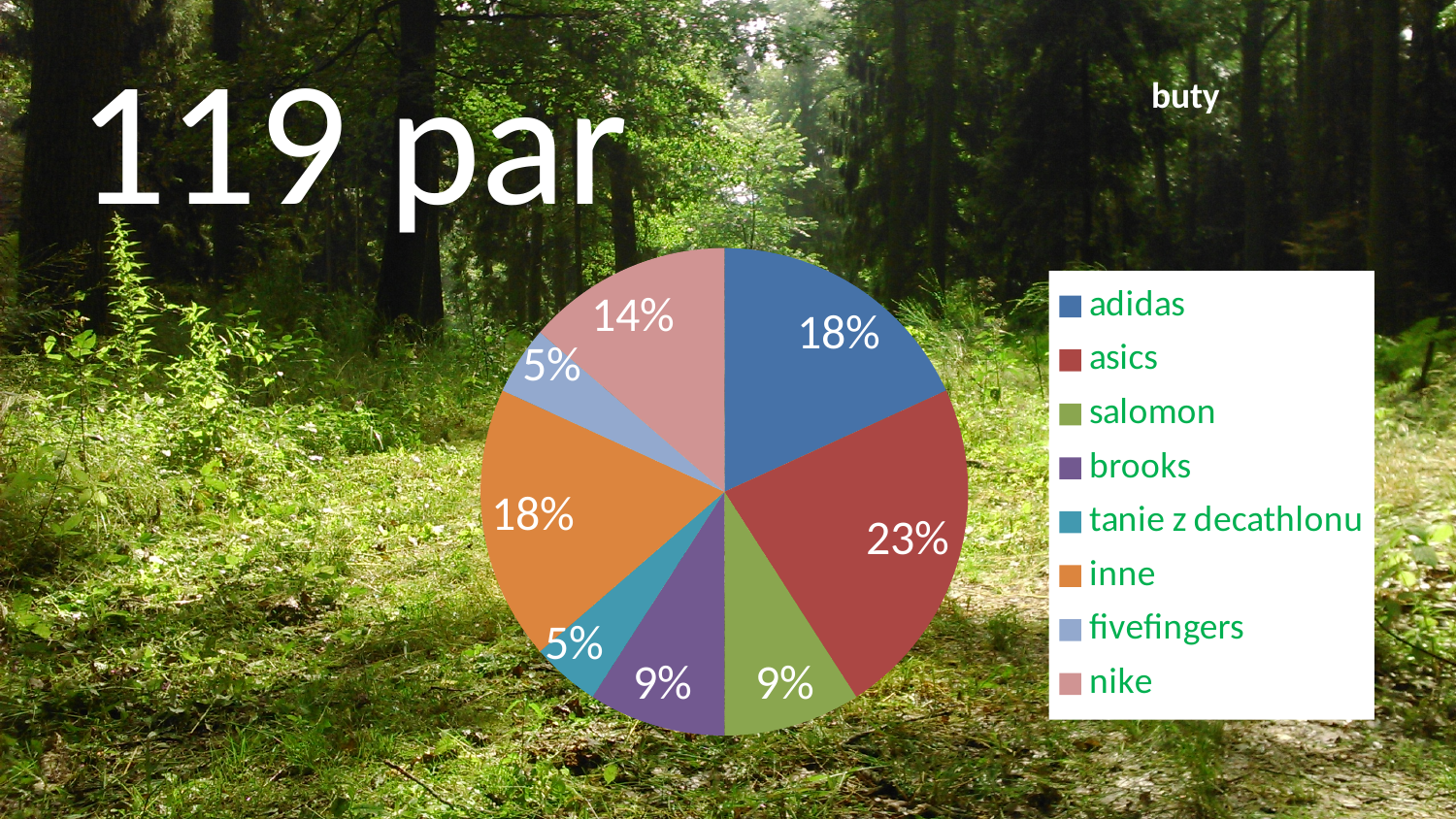
Which category has the largest slice of the pie? asics What is the value shown for fivefingers? 5% Which legend entry is shown in orange? inne What kind of chart is shown on the slide? pie chart Which is larger, the share for nike or the share for salomon? nike What is the difference in percentage points between asics and brooks? 14 What is the value shown for adidas? 18% What is the title of the chart? buty What share of the pie does nike have? 14% How many slices does the pie chart have? 8 How many entries does the legend list? 8 What share of the pie does asics have? 23%